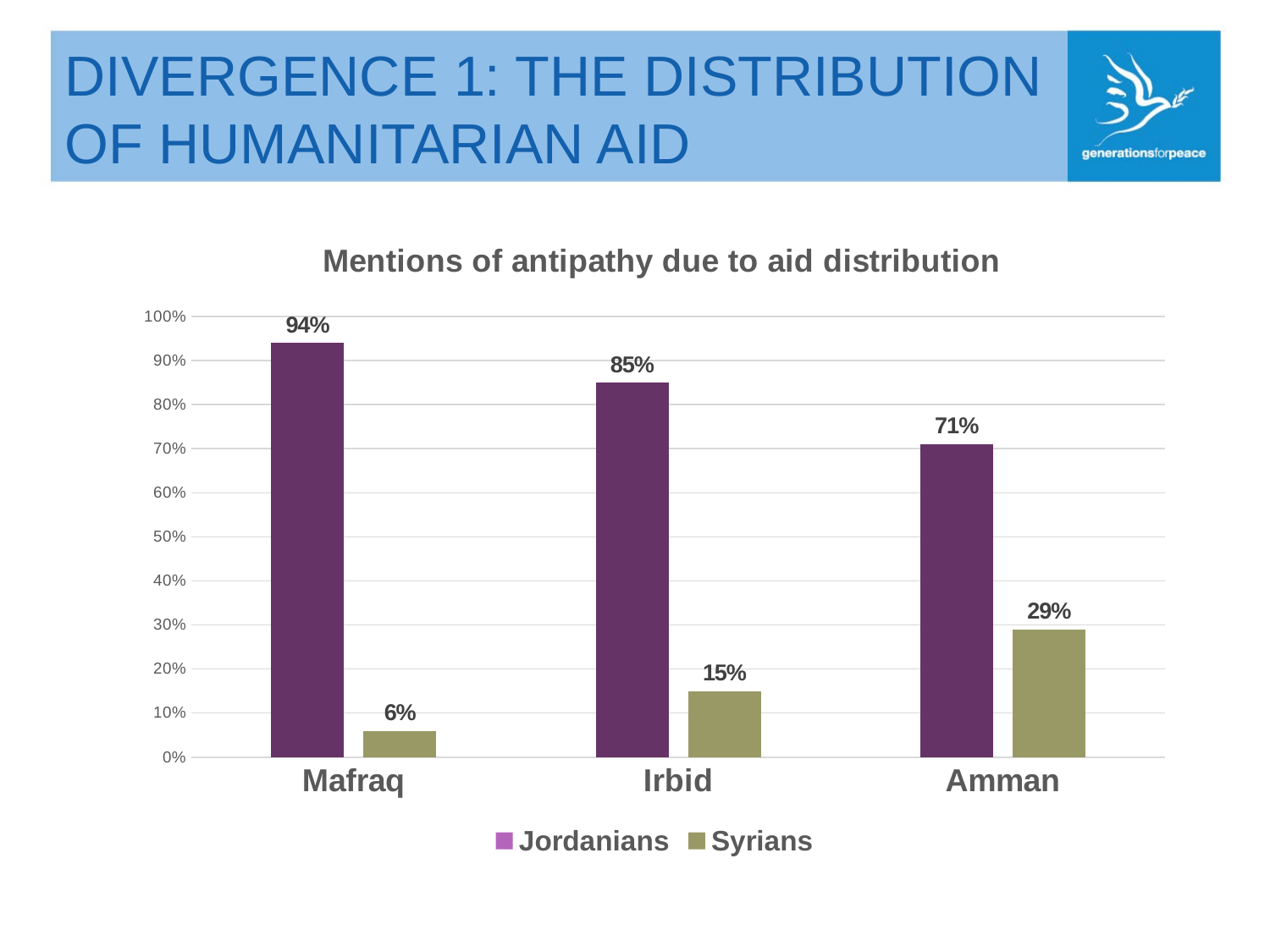
What is the difference between the Jordanians and Syrians values in Irbid? 70% What is the value for Jordanians in Mafraq? 94% What is the title of the chart? Mentions of antipathy due to aid distribution What is the value for Syrians in Amman? 29% How many series does the legend list? 2 Which is larger: the Syrians value in Amman or the Syrians value in Irbid? Amman Is the value for Jordanians in Amman greater or less than 60%? greater What is the value for Syrians in Irbid? 15% How many cities are shown on the x axis? 3 Which city has the lowest value for Syrians? Mafraq What kind of chart is shown? Bar chart Which city has the highest value for Jordanians? Mafraq